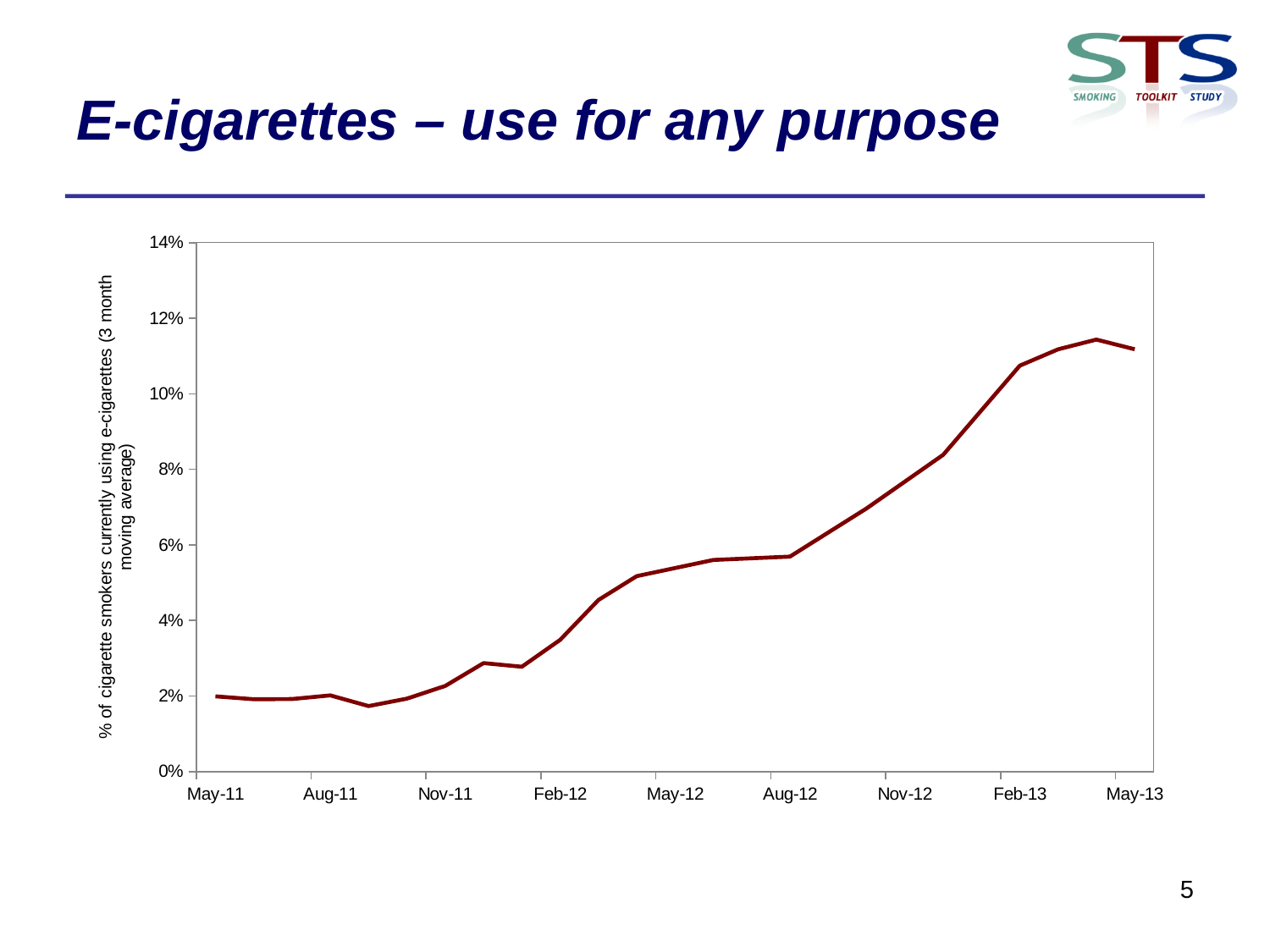
Which is larger, the value at May-11 or the value at May-13? May-13 What kind of chart is shown on the slide? line chart What is the label on the y axis? % of cigarette smokers currently using e-cigarettes (3 month moving average) Overall, do the values rise or fall from May-11 to May-13? rise Is the value at May-13 greater or less than 12%? less Is the highest point on the line greater or less than 12%? less How many date labels are shown on the x axis? 9 Is the value at Feb-13 greater or less than 10%? greater Which is larger, the value at Feb-12 or the value at Feb-13? Feb-13